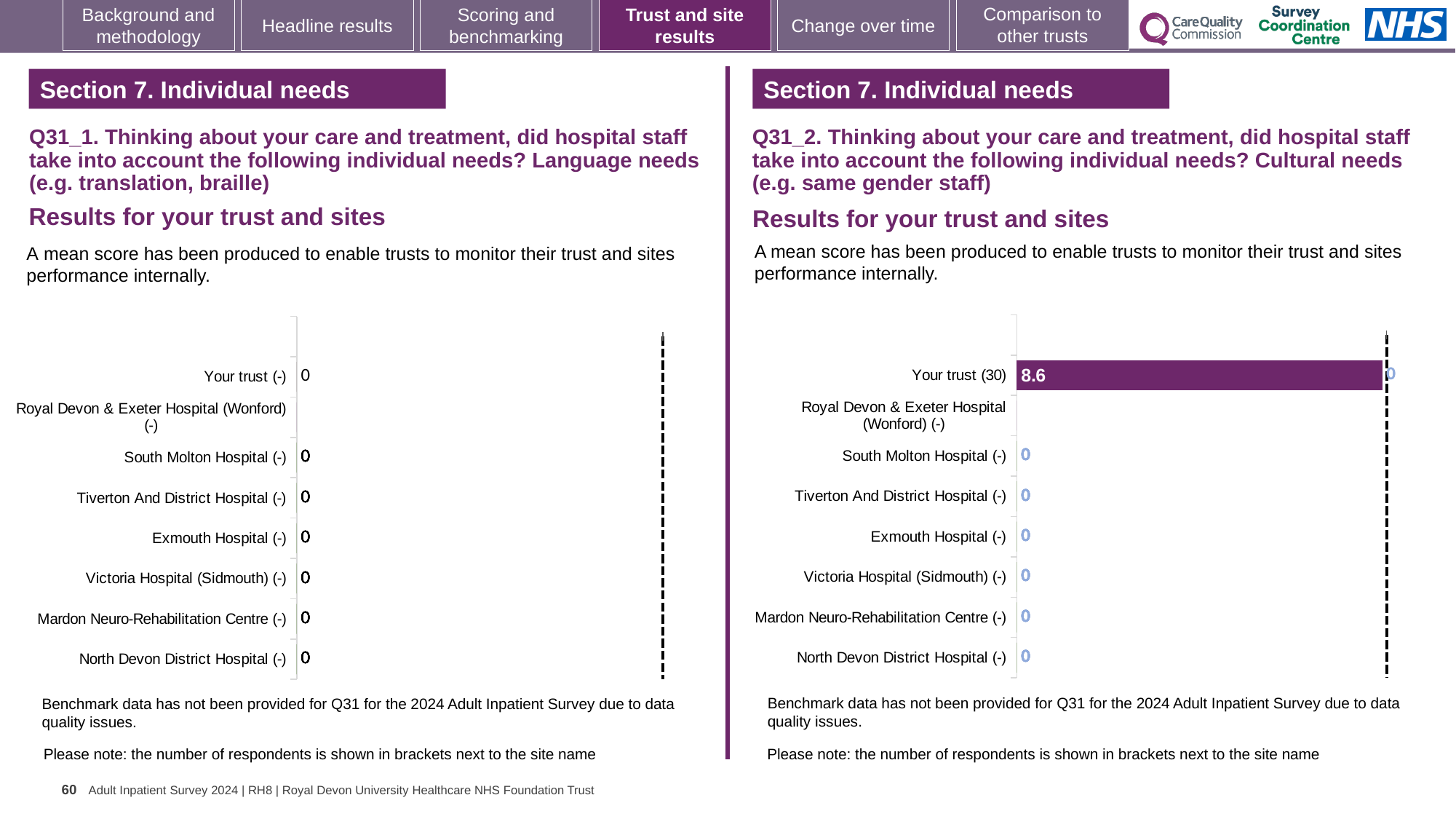
On the Q31_2 chart on the right, what is the difference between the value for Your trust (30) and the value for Tiverton And District Hospital (-)? 8.6 On the Q31_2 chart on the right, which category has the highest value? Your trust (30) On the Q31_2 chart (Cultural needs) on the right, what is the value for Your trust (30)? 8.6 What kind of chart is used on the right-hand side of the slide for Q31_2? Bar chart On the Q31_2 chart on the right, what is the value for South Molton Hospital (-)? 0 On the Q31_2 chart on the right, which is larger: the value for Your trust (30) or the value for Exmouth Hospital (-)? Your trust (30) On the Q31_2 chart on the right, how many respondents are shown in brackets next to Your trust? 30 On the Q31_1 chart (Language needs) on the left, what is the value for Your trust (-)? 0 How many categories are listed on the Q31_1 chart on the left? 8 How many categories are listed on the Q31_2 chart on the right? 8 Which individual need does the left-hand chart (Q31_1) relate to? Language needs (e.g. translation, braille) On the Q31_1 chart on the left, what is the value for North Devon District Hospital (-)? 0